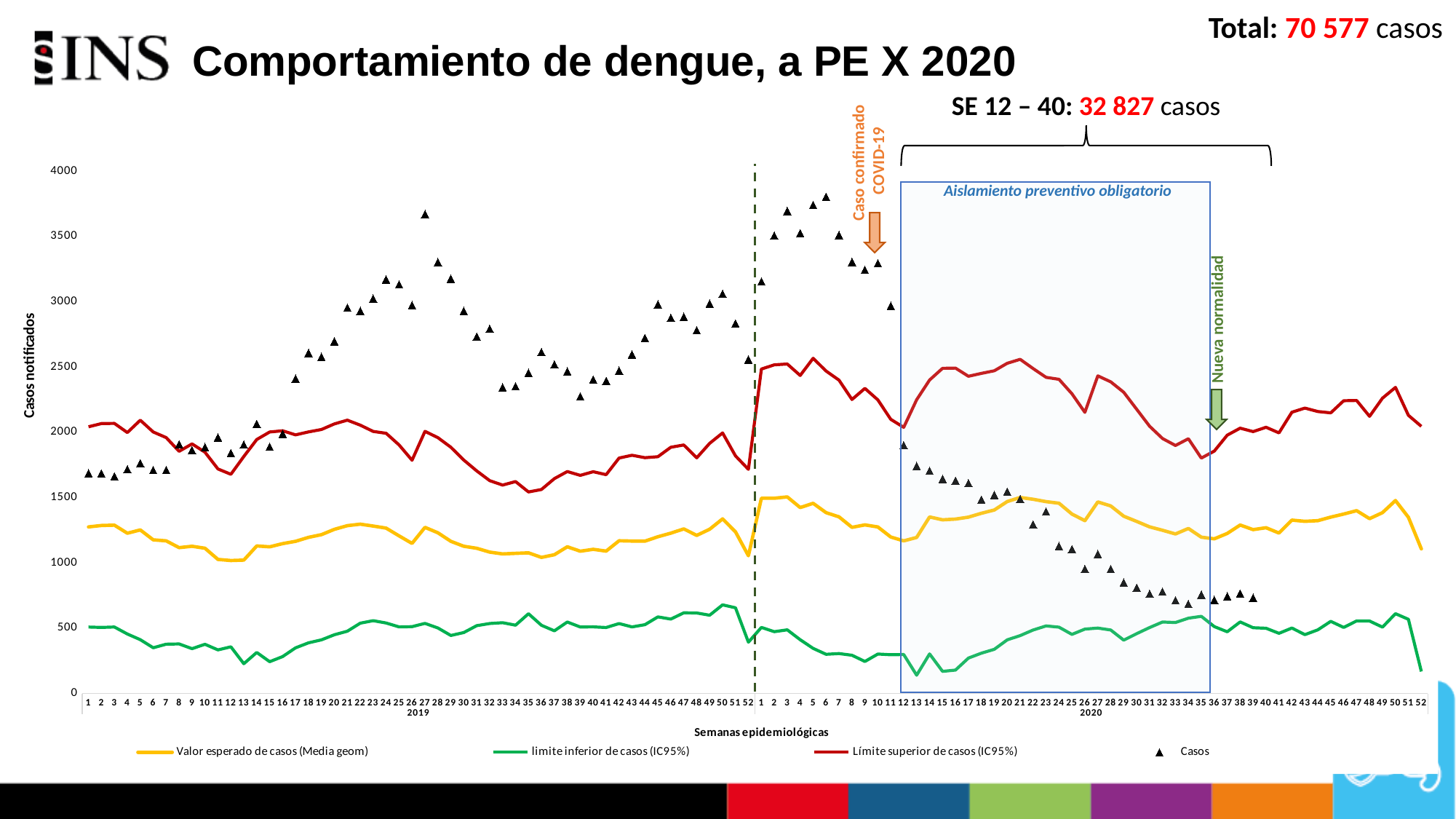
What kind of chart is shown on the slide? line chart How many epidemiological weeks are shown on the x axis for 2019? 52 Which is larger, the Casos value at week 27 of 2019 or the Casos value at week 39 of 2020? week 27 of 2019 Is the value of Casos at week 39 of 2020 greater or less than 1000? less Is the value of Casos at week 1 of 2019 greater or less than 2000? less Is the Límite superior de casos (IC95%) line at week 1 of 2020 greater or less than 2000? greater What is the label of the vertical axis? Casos notificados Do the Casos values rise or fall from week 12 to week 39 of 2020? fall How many series does the legend list? 4 What is the title of the chart? Comportamiento de dengue, a PE X 2020